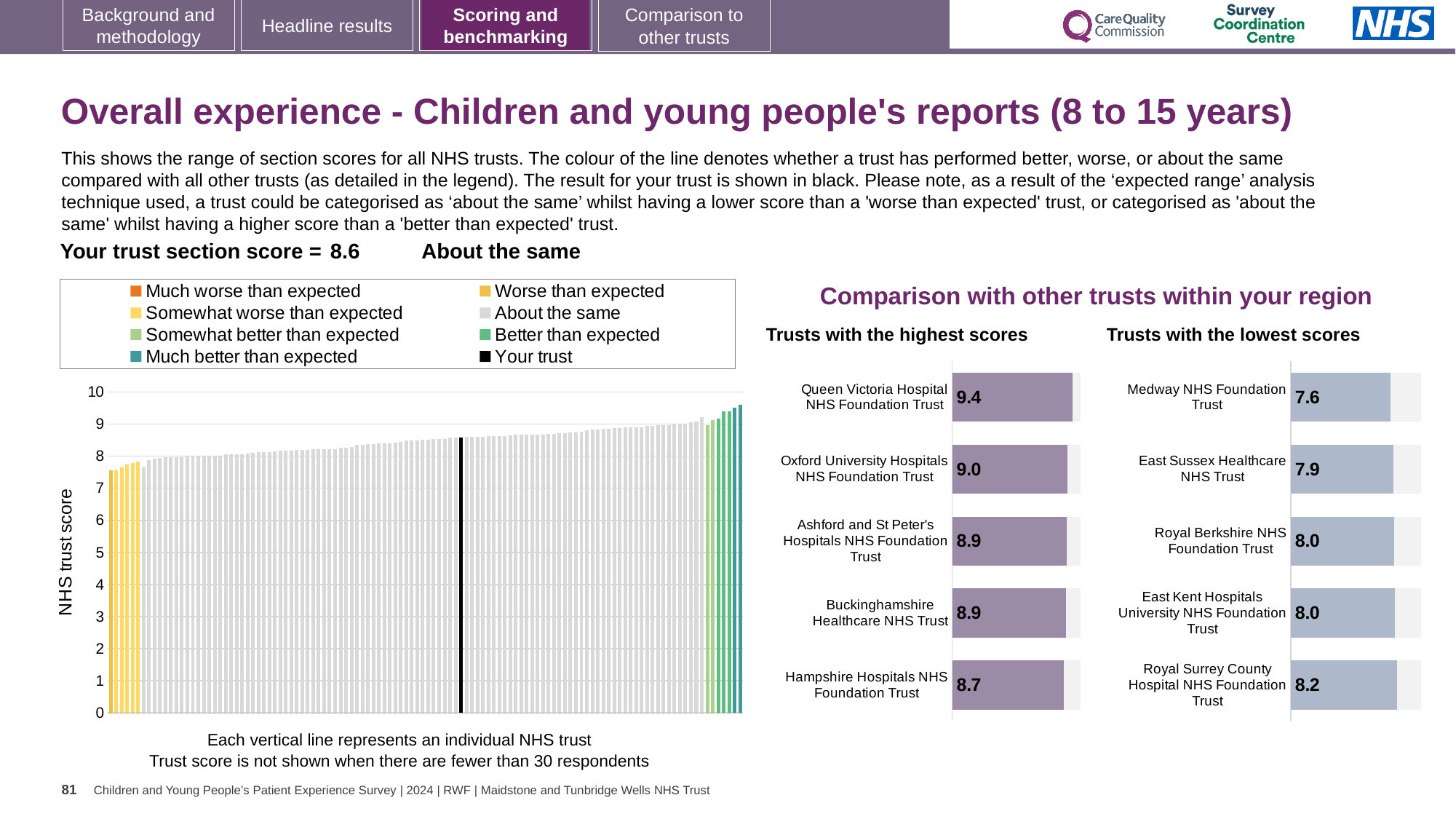
In the 'Trusts with the lowest scores' chart, what is the difference between the scores of Royal Surrey County Hospital NHS Foundation Trust and Medway NHS Foundation Trust? 0.6 In the 'Trusts with the lowest scores' chart, what is the score for Medway NHS Foundation Trust? 7.6 In the 'Trusts with the lowest scores' chart, which has the larger score: East Sussex Healthcare NHS Trust or Royal Surrey County Hospital NHS Foundation Trust? Royal Surrey County Hospital NHS Foundation Trust In the 'Trusts with the highest scores' chart, which trust has the highest score? Queen Victoria Hospital NHS Foundation Trust In the 'Trusts with the lowest scores' chart, which trust has the lowest score? Medway NHS Foundation Trust In the 'Trusts with the lowest scores' chart, what is the score for Royal Surrey County Hospital NHS Foundation Trust? 8.2 In the 'Trusts with the highest scores' chart, what is the score for Hampshire Hospitals NHS Foundation Trust? 8.7 In the large chart on the left showing all NHS trusts, do the trust scores rise or fall from left to right? Rise In the 'Trusts with the highest scores' chart, what is the score for Queen Victoria Hospital NHS Foundation Trust? 9.4 In the 'Trusts with the highest scores' chart, what is the difference between the scores of Queen Victoria Hospital NHS Foundation Trust and Hampshire Hospitals NHS Foundation Trust? 0.7 In the 'Trusts with the highest scores' chart, how many trusts are shown? 5 In the large chart on the left showing all NHS trusts, what kind of chart is it? Bar chart